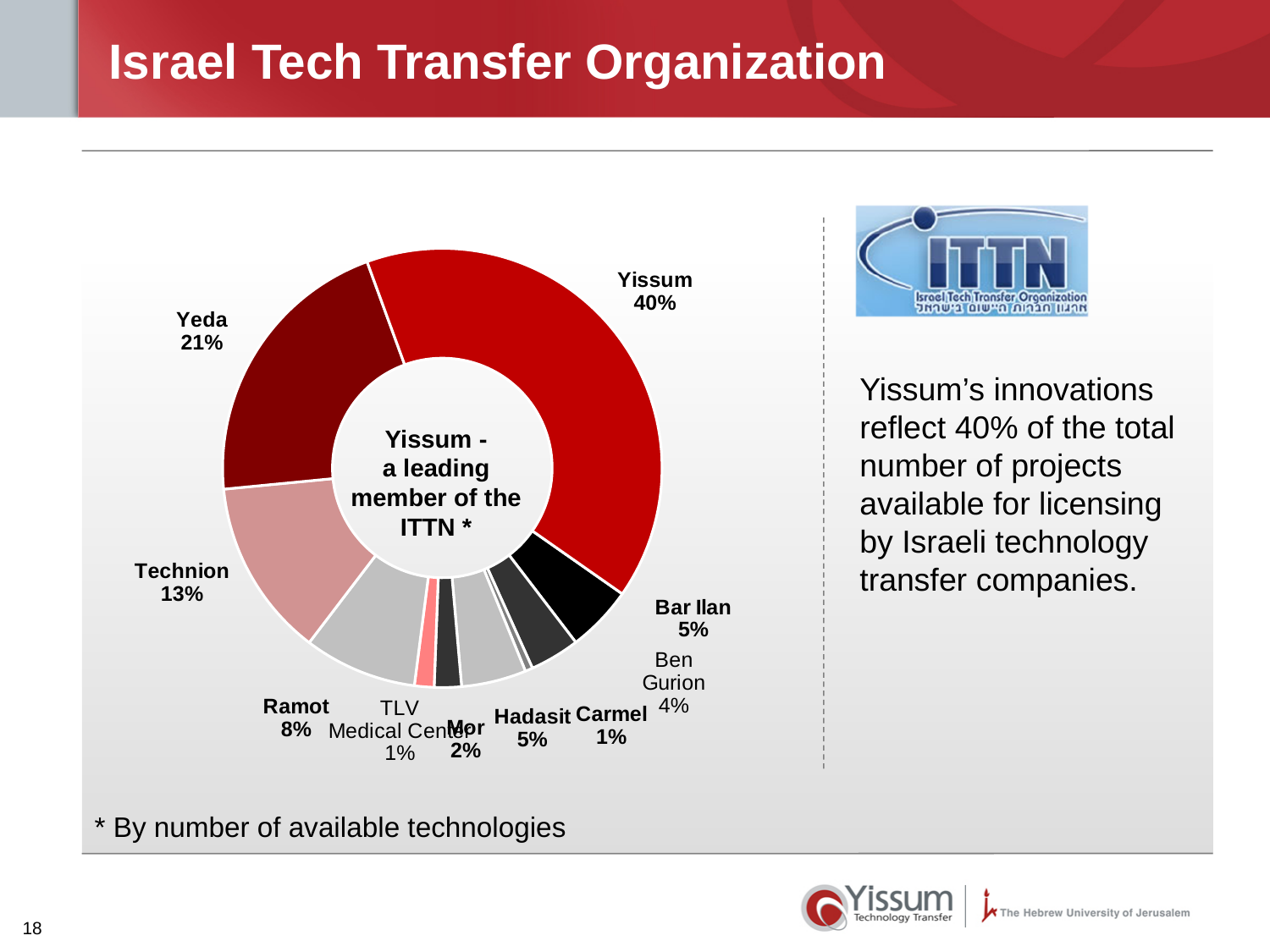
What type of chart is shown on the slide? Donut (pie) chart What percentage is shown for Yeda? 21% What percentage is shown for Mor? 2% What percentage is shown for Technion? 13% Which organization has the largest share in the chart? Yissum How many organizations are shown as slices in the chart? 10 What share of the donut chart does Yissum hold? 40% Which has a larger share, Technion or Ramot? Technion What is the difference in percentage points between Yissum and Yeda? 19 What is the combined share of Bar Ilan and Hadasit? 10% What percentage is shown for Ben Gurion? 4% What text appears in the center of the donut chart? Yissum - a leading member of the ITTN *